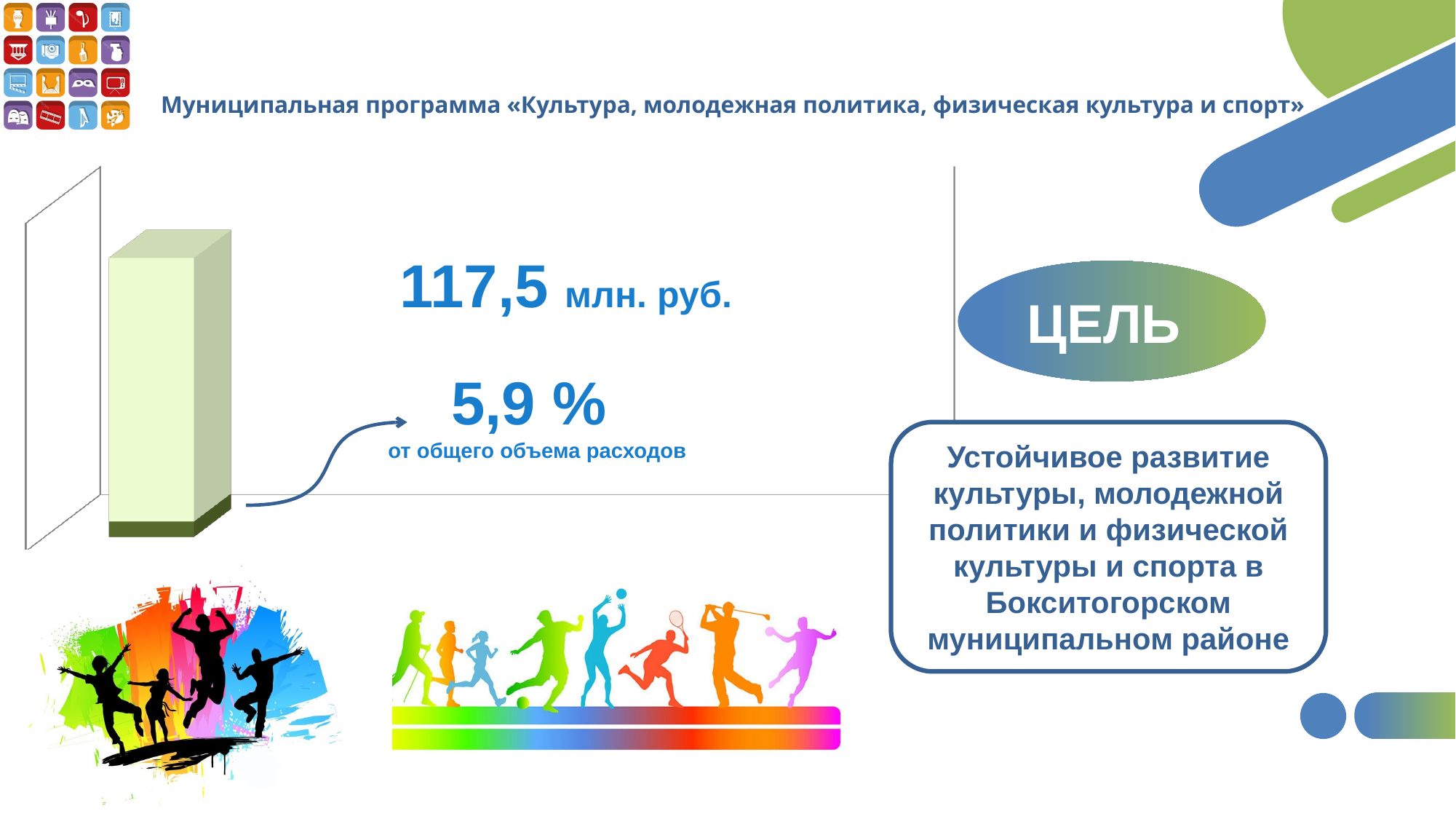
What colour is the bar in the chart on the slide? light green What percentage of total expenditures does the bar on the slide represent? 5,9 % How many bars are plotted in the chart on the slide? 1 What is the title of the program shown at the top of the slide? Муниципальная программа «Культура, молодежная политика, физическая культура и спорт» What value in million rubles is shown for the bar on the slide? 117,5 млн. руб. What kind of chart is shown on the left of the slide? bar chart